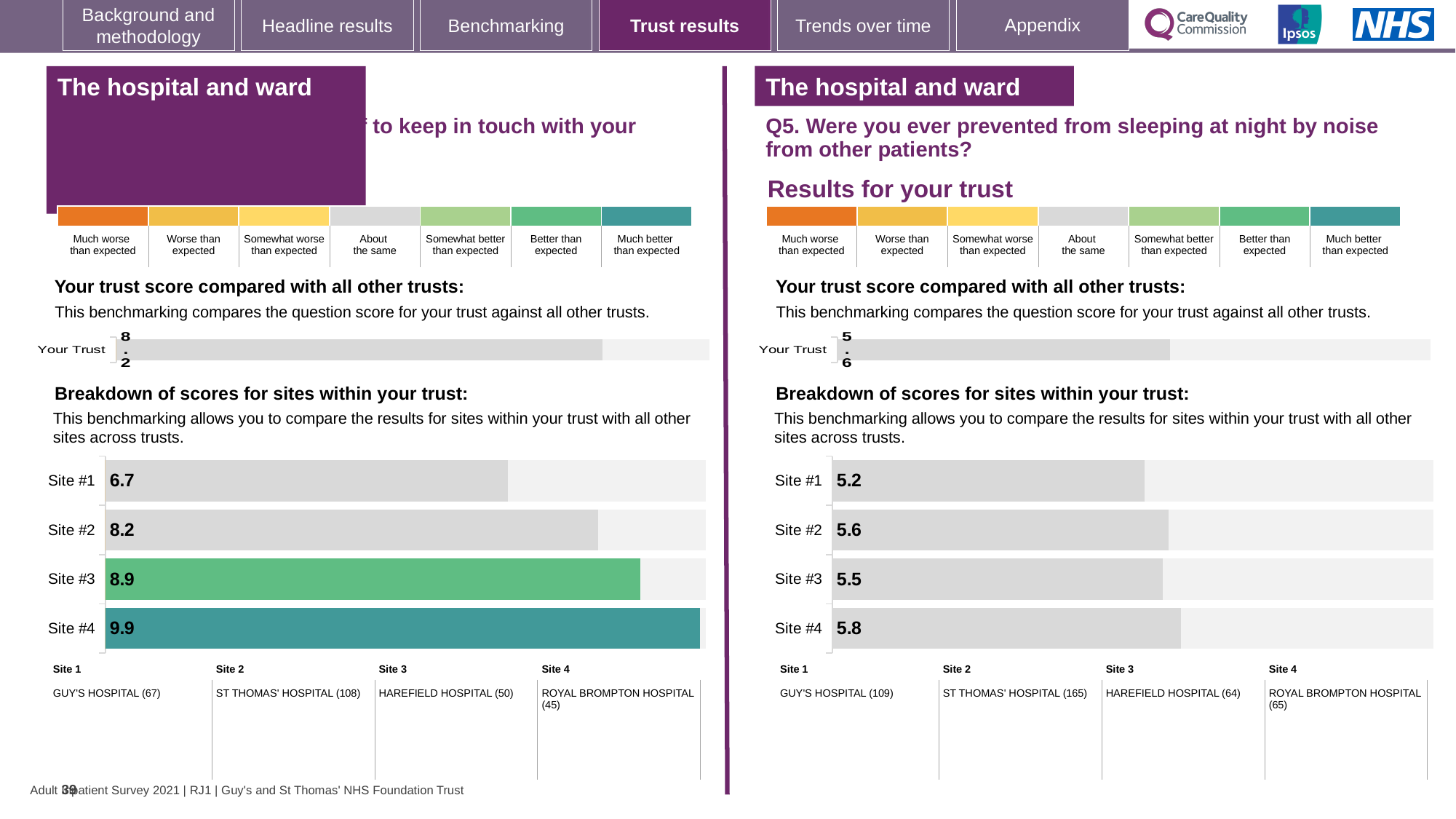
On the left-hand chart, which site has the highest score? Site #4 On the Q5 chart (noise from other patients), which site has the lowest score? Site #1 On the left-hand chart, what is the difference between the scores for Site #4 and Site #1? 3.2 On the Q5 chart (noise from other patients), which site has the highest score? Site #4 On the Q5 chart (noise from other patients), how many sites are shown in the breakdown? 4 What type of chart is used for the breakdown of scores for sites on the Q5 chart? Bar chart On the left-hand chart, which site has the lowest score? Site #1 On the Q5 chart (noise from other patients), what is the score for Site #2? 5.6 On the Q5 chart (noise from other patients), what is the difference between the scores for Site #4 and Site #1? 0.6 On the left-hand chart, what is the 'Your Trust' score? 8.2 On the left-hand chart, what is the score for Site #1? 6.7 On the left-hand chart, what is the score for Site #4? 9.9